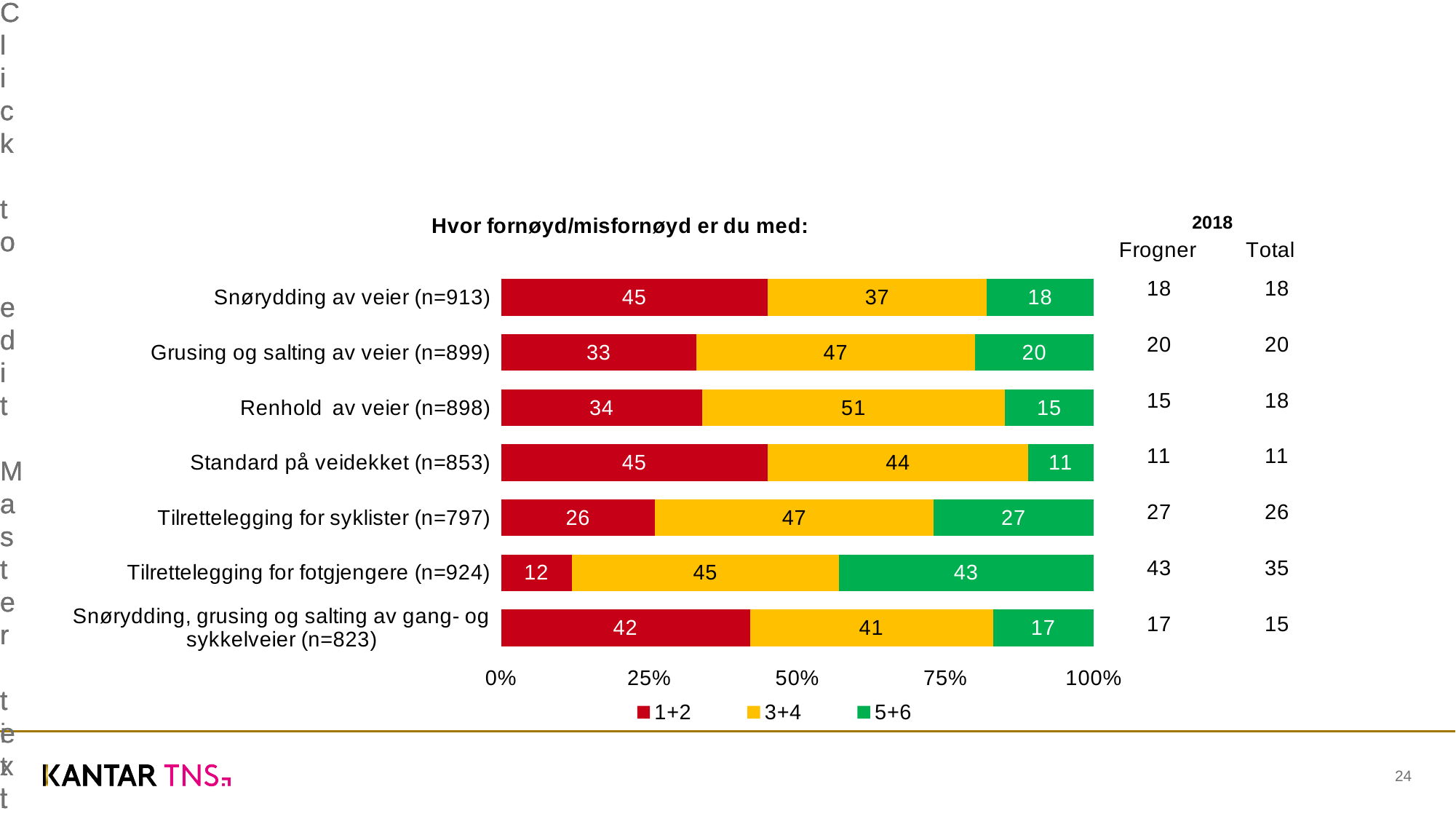
What is the value of the 3+4 series for Renhold av veier (n=898)? 51 How many categories are plotted in the chart? 7 What is the difference between the 3+4 value for Renhold av veier (n=898) and the 3+4 value for Snørydding av veier (n=913)? 14 What is the value of the 5+6 series for Tilrettelegging for fotgjengere (n=924)? 43 What is the value of the 1+2 series for Snørydding av veier (n=913)? 45 What is the title of the chart? Hvor fornøyd/misfornøyd er du med: What is the total of the stacked bar for Standard på veidekket (n=853)? 100 Which category has the lowest value in the 1+2 series? Tilrettelegging for fotgjengere (n=924) Which is larger: the 5+6 value for Tilrettelegging for syklister (n=797) or the 5+6 value for Grusing og salting av veier (n=899)? Tilrettelegging for syklister (n=797) What kind of chart is shown on the slide? Stacked bar chart Which category has the highest value in the 5+6 series? Tilrettelegging for fotgjengere (n=924) How many series does the legend list? 3